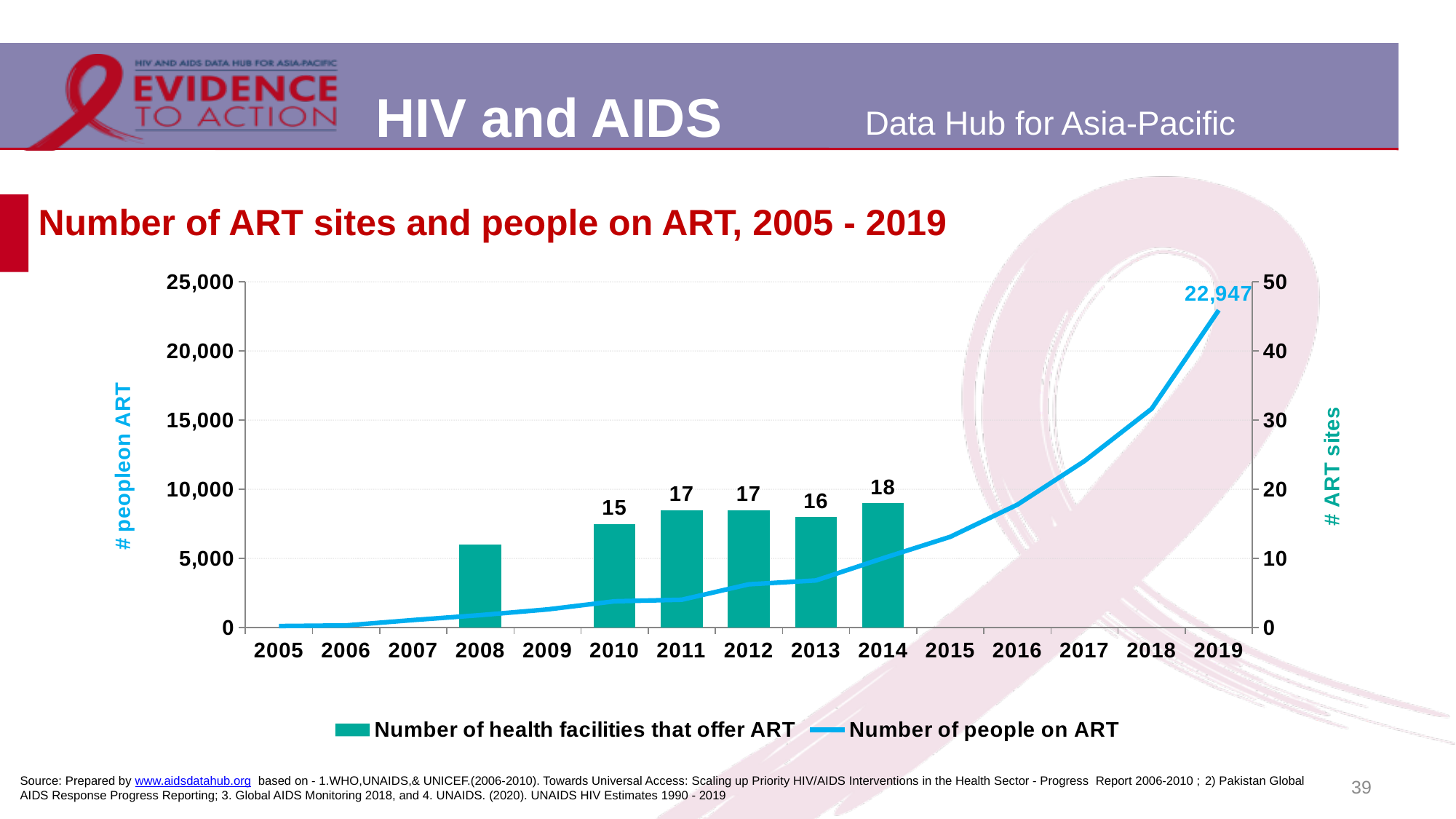
Does the number of people on ART rise or fall from 2005 to 2019? Rise What kind of chart is shown on the slide? Combination bar and line chart What is the number of people on ART in 2019? 22,947 What is the number of health facilities that offer ART in 2010? 15 Which year has the lowest bar for number of health facilities that offer ART? 2008 What is the difference between the number of health facilities that offer ART in 2014 and in 2010? 3 What is the number of health facilities that offer ART in 2014? 18 Is the number of people on ART in 2016 greater or less than 10,000? less Which year has more health facilities that offer ART, 2013 or 2014? 2014 Which year has the highest number of health facilities that offer ART? 2014 How many years are shown on the x axis? 15 How many series does the legend list? 2